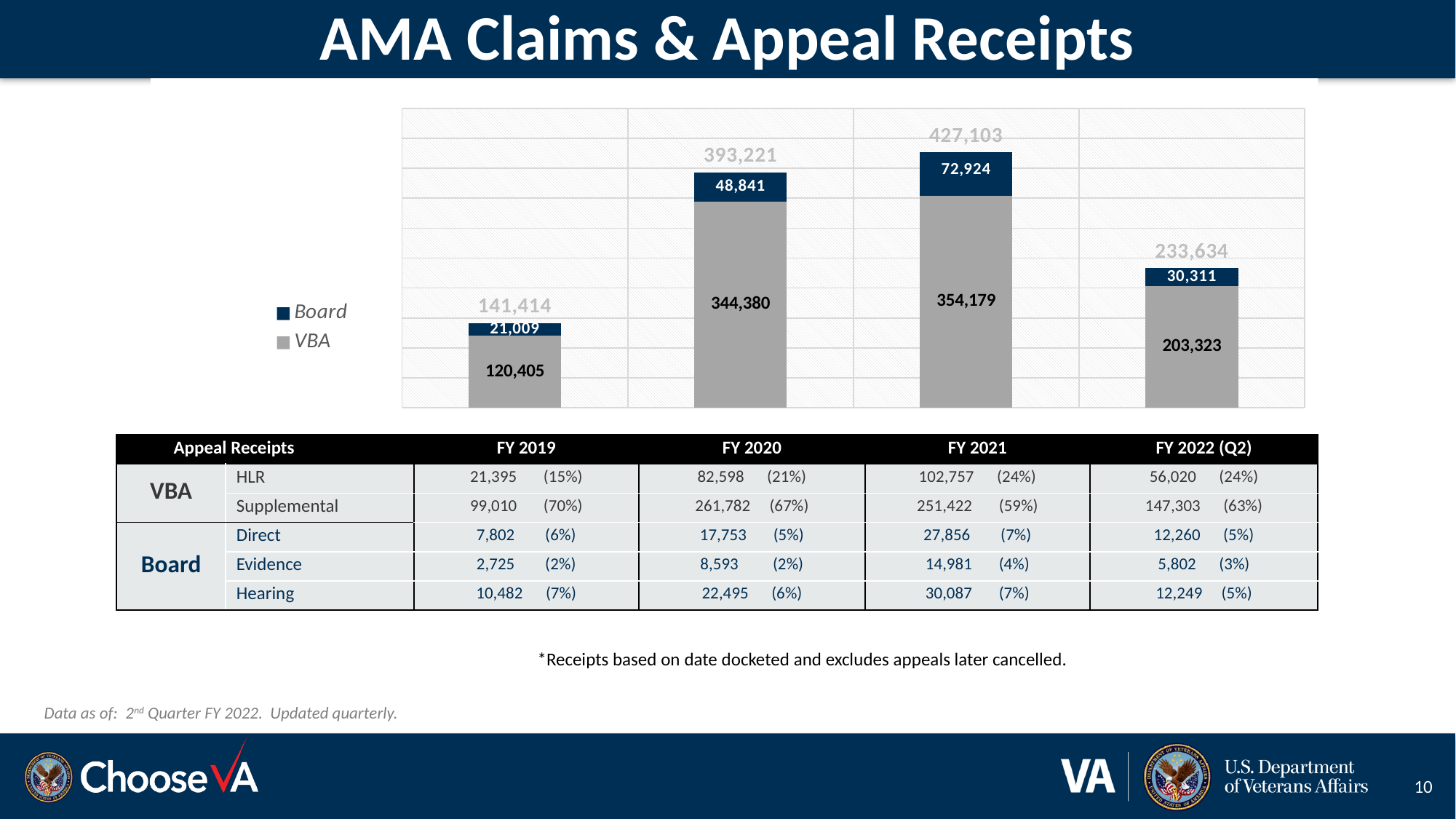
What is the VBA value for the first (leftmost) bar in the chart? 120,405 What is the Board value for the third bar from the left in the chart? 72,924 Which bar in the chart has the highest total? the third bar from the left (427,103) What is the difference between the Board value of the third bar (72,924) and the Board value of the second bar (48,841)? 24,083 How many stacked bars are plotted in the chart? 4 Does the total rise or fall from the third bar to the fourth bar in the chart? fall How many series does the chart legend list? 2 What kind of chart is shown on the slide? stacked bar chart Which is larger in the chart: the VBA value of the second bar or the VBA value of the third bar? the third bar (354,179) What are the two series named in the chart legend? Board and VBA What is the total shown above the second bar from the left in the chart? 393,221 Which bar in the chart has the lowest Board value? the first (leftmost) bar (21,009)